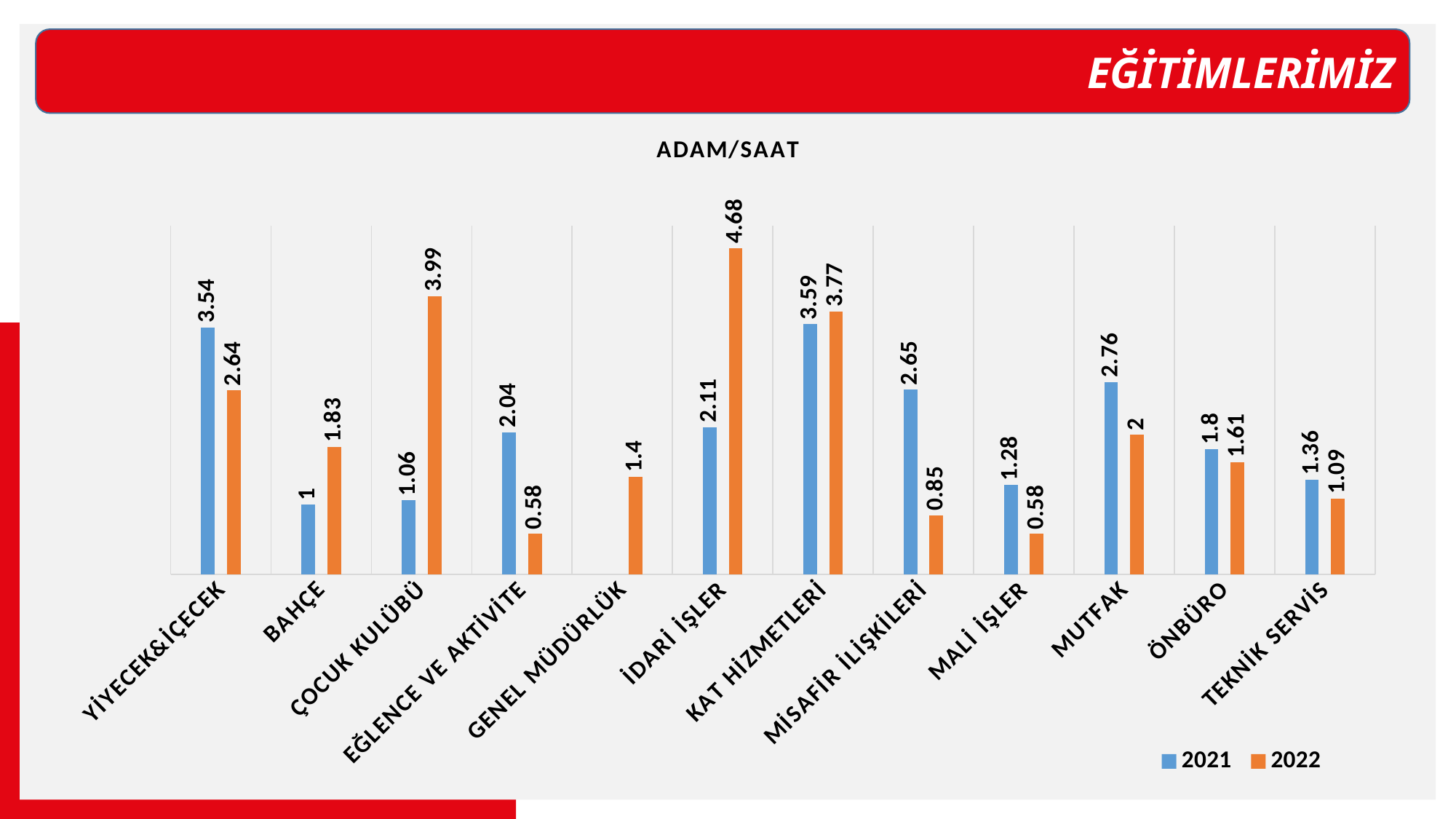
What is the 2022 value for İDARİ İŞLER? 4.68 Which category has the highest 2022 value? İDARİ İŞLER What is the 2021 value for YİYECEK&İÇECEK? 3.54 What is the difference between the 2022 and 2021 values for ÇOCUK KULÜBÜ? 2.93 Which colour represents the 2022 series in the legend? Orange What is the title of the chart? ADAM/SAAT How many categories are shown on the x axis? 12 Which is larger for MUTFAK, the 2021 value or the 2022 value? 2021 What is the 2022 value for GENEL MÜDÜRLÜK? 1.4 Which category has the lowest 2021 value? BAHÇE What kind of chart is shown on the slide? Bar chart How many series does the legend list? 2